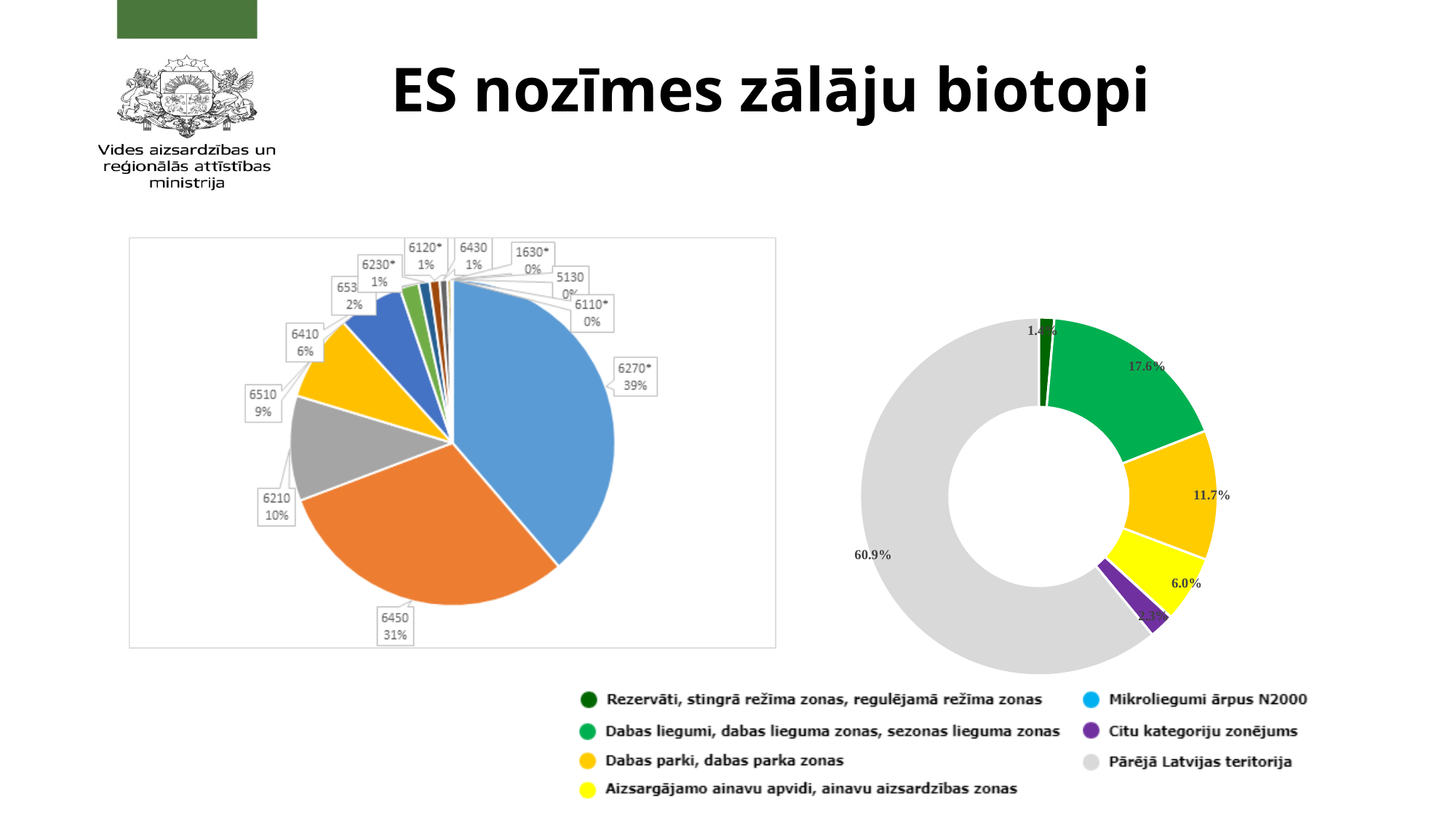
In the right doughnut chart, which colour represents Citu kategoriju zonējums? Purple How many entries does the legend of the right doughnut chart list? 7 In the left pie chart, which has the larger share, habitat 6410 or habitat 6510? 6510 What kind of chart is the chart on the right side of the slide? Doughnut (pie) chart In the left pie chart, what percentage is shown for habitat 6270*? 39% In the left pie chart, which habitat code has the largest share? 6270* In the right doughnut chart, what percentage is shown for Dabas liegumi, dabas lieguma zonas, sezonas lieguma zonas? 17.6% In the left pie chart, what percentage is shown for habitat 6450? 31% In the right doughnut chart, what percentage is shown for Dabas parki, dabas parka zonas? 11.7% In the right doughnut chart, what percentage is shown for Pārējā Latvijas teritorija? 60.9% In the left pie chart, what percentage is shown for habitat 6410? 6% In the left pie chart, what is the difference in percentage points between habitat 6210 and habitat 6510? 1%